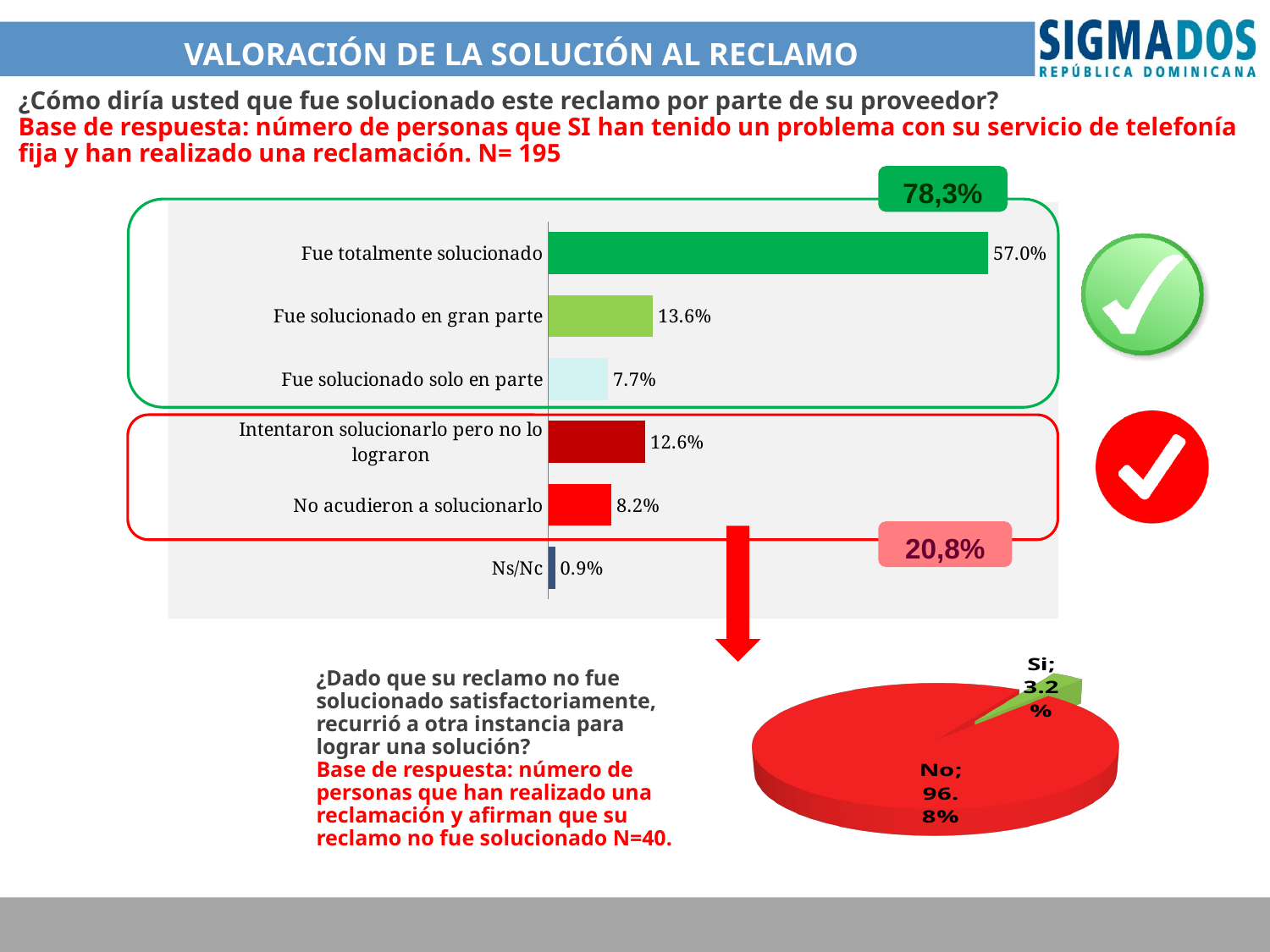
In the bar chart, what is the difference between "Fue totalmente solucionado" and "Fue solucionado en gran parte"? 43.4% In the bar chart, what is the value for "Fue totalmente solucionado"? 57.0% In the bar chart, which category has the lowest value? Ns/Nc How many categories does the bar chart show? 6 In the pie chart at the bottom, what share does the "No" slice have? 96.8% In the bar chart, which is larger: "No acudieron a solucionarlo" or "Fue solucionado solo en parte"? No acudieron a solucionarlo In the pie chart at the bottom, what share does the "Si" slice have? 3.2% What kind of chart is the top chart on the slide? Bar chart In the bar chart, what is the value for "Intentaron solucionarlo pero no lo lograron"? 12.6% In the bar chart, which category has the highest value? Fue totalmente solucionado In the bar chart, what is the value for "Fue solucionado en gran parte"? 13.6% In the bar chart, what is the value for "Ns/Nc"? 0.9%